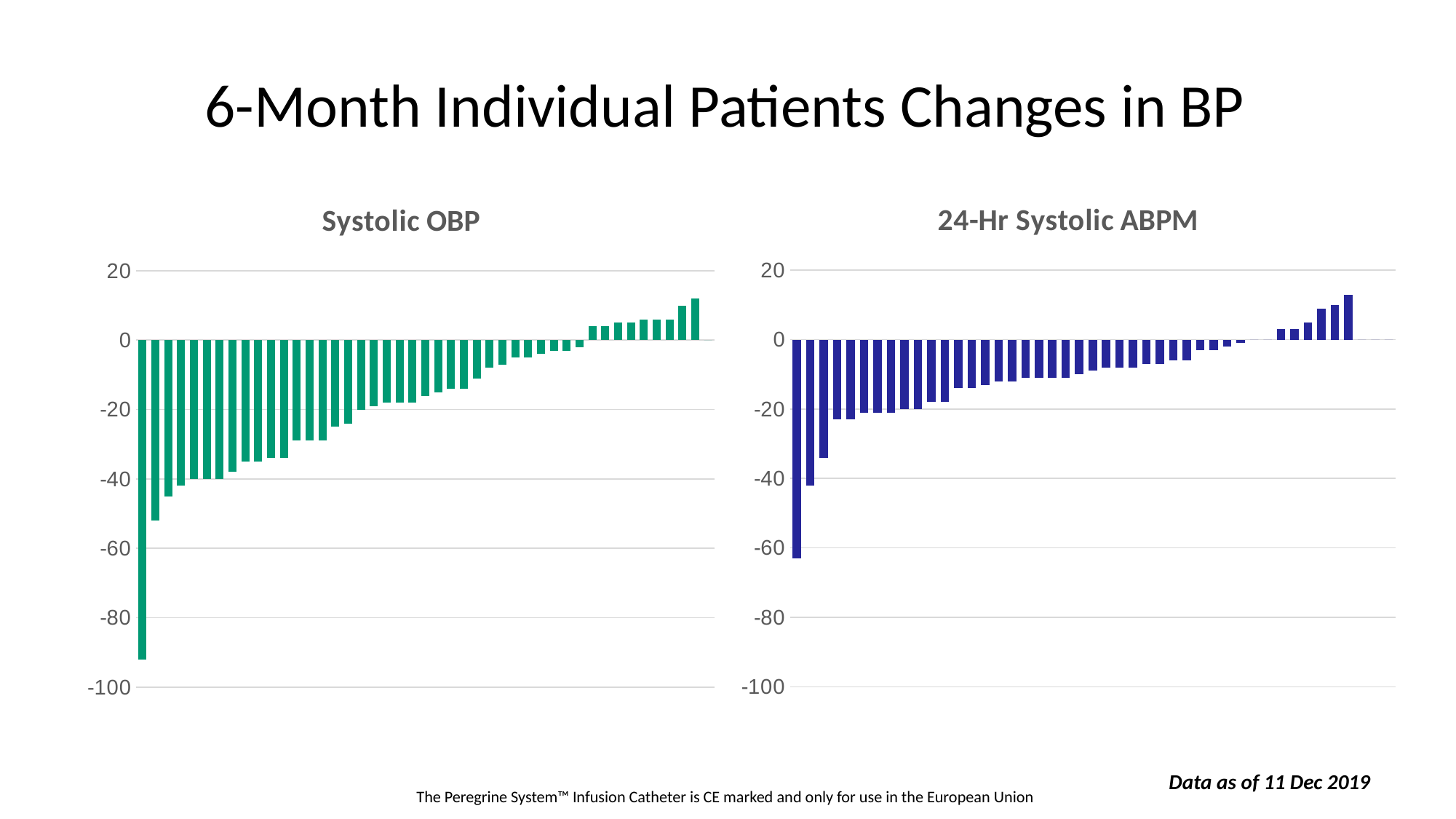
What is the title of the chart on the left? Systolic OBP What kind of chart is the Systolic OBP chart on the left? Bar chart In the 24-Hr Systolic ABPM chart, is the value of the leftmost bar greater or less than -60? less Which chart has the lower leftmost bar value, Systolic OBP or 24-Hr Systolic ABPM? Systolic OBP In the Systolic OBP chart, is the value of the leftmost bar greater or less than -80? less What kind of chart is the 24-Hr Systolic ABPM chart on the right? Bar chart What colour are the bars in the 24-Hr Systolic ABPM chart? Blue In the 24-Hr Systolic ABPM chart, is the value of the rightmost bar greater or less than 10? greater In the Systolic OBP chart, do the bar values rise or fall from left to right? Rise In the 24-Hr Systolic ABPM chart, do the bar values rise or fall from left to right? Rise